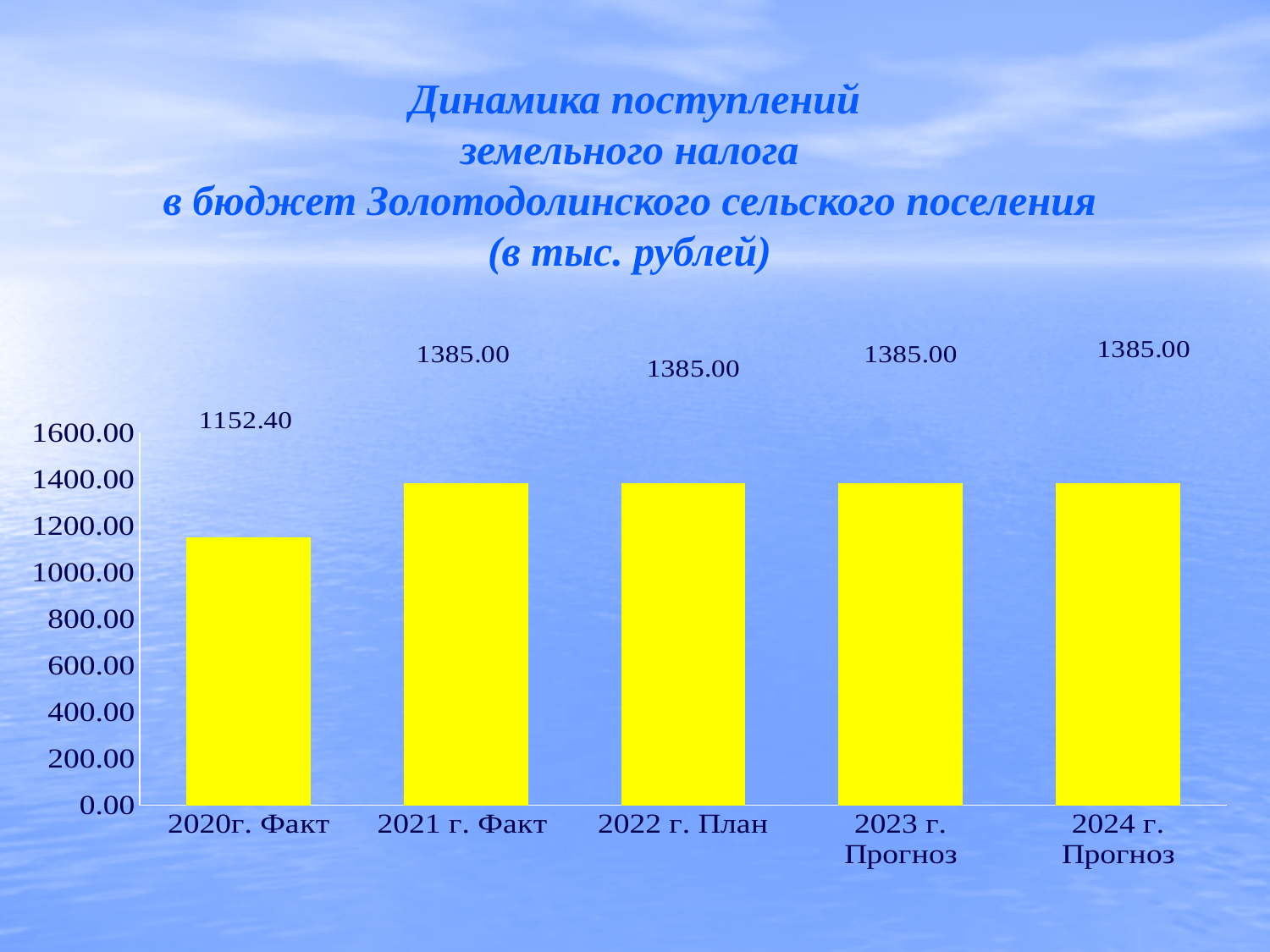
What colour are the bars in the chart? yellow How many categories are shown on the x axis? 5 Which category has the lowest value? 2020г. Факт Do the values rise or fall from 2020г. Факт to 2021 г. Факт? rise What is the value for 2020г. Факт? 1152.40 Which is larger, the value for 2020г. Факт or the value for 2022 г. План? 2022 г. План Is the value for 2020г. Факт greater or less than 1200.00? less What kind of chart is shown on the slide? bar chart What is the value for 2021 г. Факт? 1385.00 What is the difference between the values for 2021 г. Факт and 2020г. Факт? 232.60 Is the value for 2023 г. Прогноз greater or less than 1200.00? greater What is the value for 2024 г. Прогноз? 1385.00